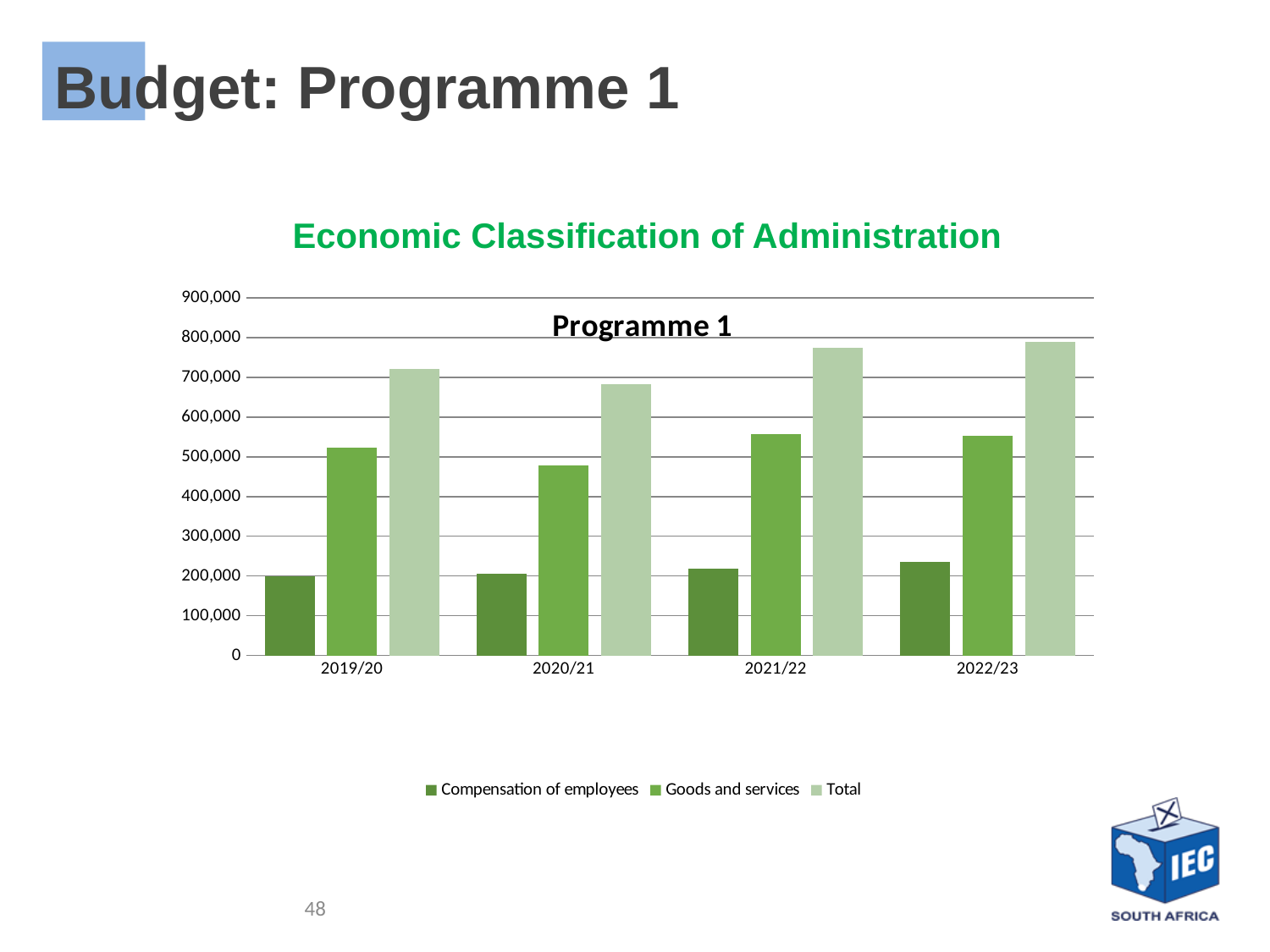
What kind of chart is shown on the slide? bar chart Is the value for Total in 2019/20 greater or less than 700,000? greater Is the value for Compensation of employees in 2022/23 greater or less than 200,000? greater Which is larger, Goods and services in 2019/20 or in 2020/21? 2019/20 How many financial years are shown on the x axis? 4 Is the value for Total in 2020/21 greater or less than 700,000? less What is the title of the chart? Programme 1 Does Compensation of employees rise or fall from 2019/20 to 2022/23? rise How many series does the legend list? 3 In which year is Compensation of employees highest? 2022/23 In which year is Goods and services lowest? 2020/21